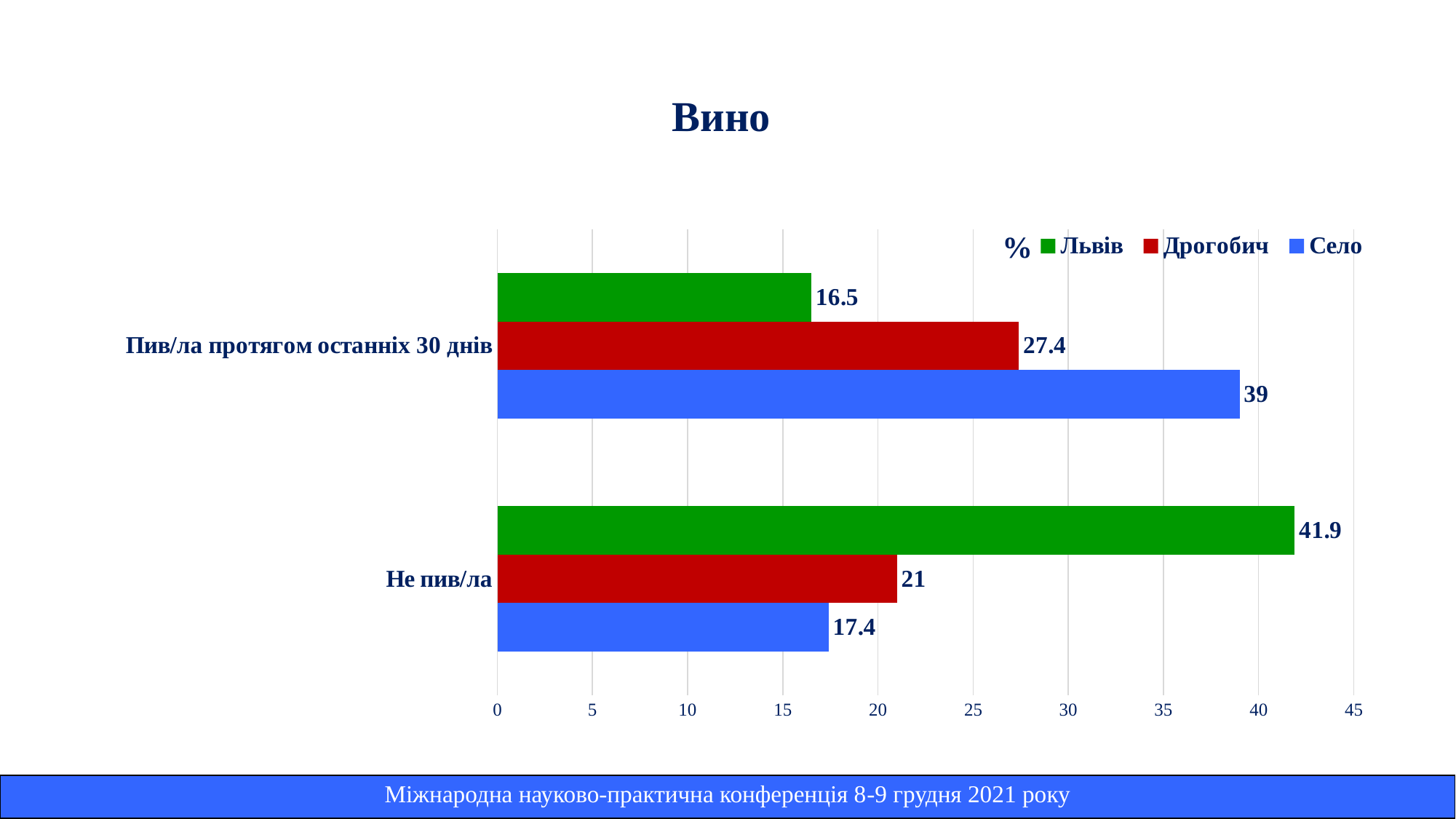
What is the value for Львів in the category 'Пив/ла протягом останніх 30 днів'? 16.5 What kind of chart is shown on the slide? Bar chart How many series does the legend list? 3 Which series has the lowest value in the category 'Не пив/ла'? Село Is the value for Львів in 'Не пив/ла' greater or less than 40? greater Which is larger: the Дрогобич value for 'Пив/ла протягом останніх 30 днів' or the Дрогобич value for 'Не пив/ла'? Пив/ла протягом останніх 30 днів How many categories are shown on the y axis? 2 Which series has the highest value in the category 'Пив/ла протягом останніх 30 днів'? Село What is the difference between the Село and Львів values in the category 'Пив/ла протягом останніх 30 днів'? 22.5 What is the value for Дрогобич in the category 'Не пив/ла'? 21 What is the value for Село in the category 'Не пив/ла'? 17.4 What is the difference between the Львів and Дрогобич values in the category 'Не пив/ла'? 20.9